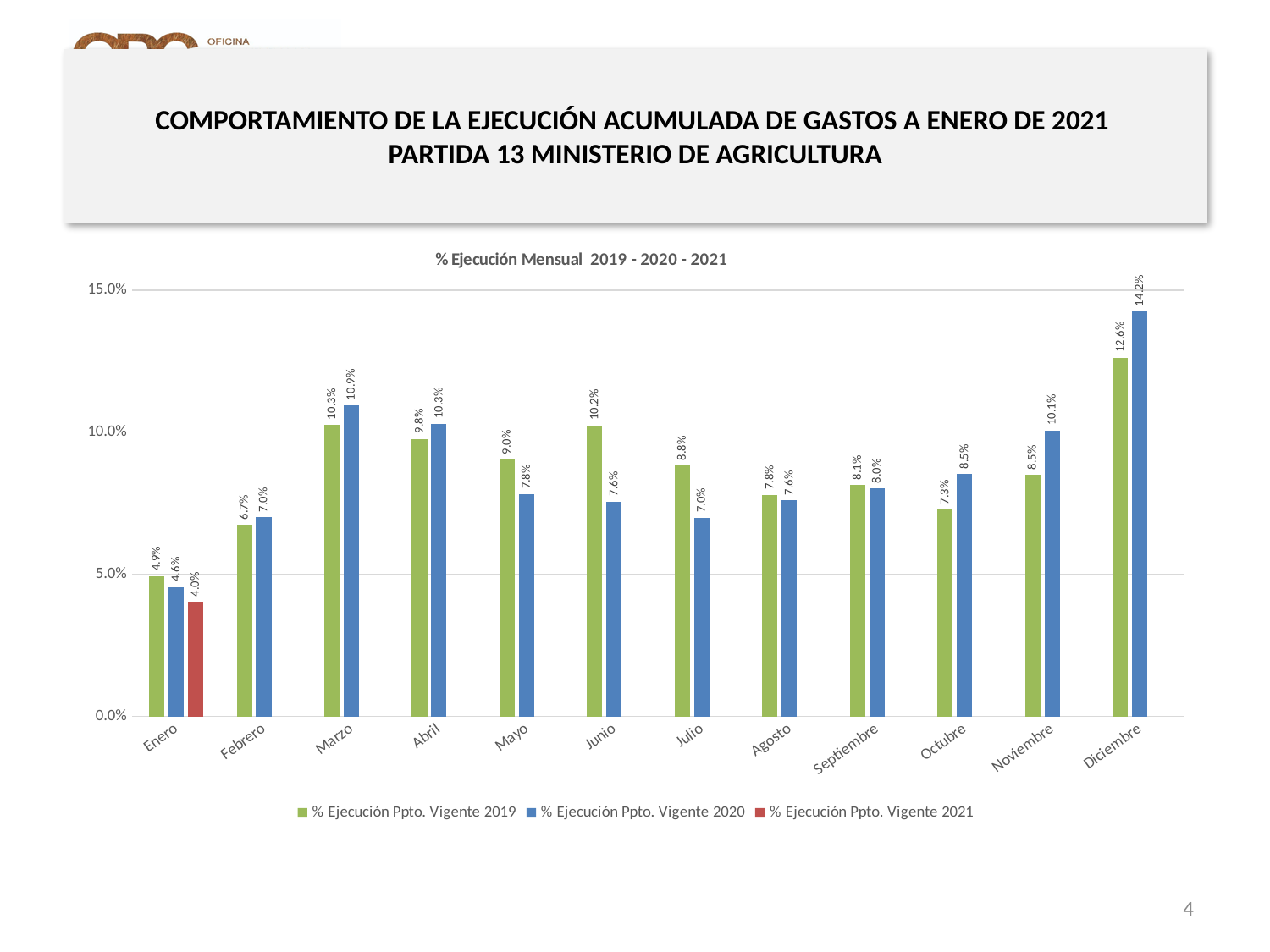
In which month is the % Ejecución Ppto. Vigente 2019 series lowest? Enero Which is larger in Mayo: the 2019 value or the 2020 value? 2019 (9.0%) What is the value for % Ejecución Ppto. Vigente 2019 in Junio? 10.2% How many series does the legend list? 3 What is the value for % Ejecución Ppto. Vigente 2021 in Enero? 4.0% What kind of chart is shown on the slide? Bar chart In which month is the % Ejecución Ppto. Vigente 2020 series highest? Diciembre How many months are shown on the x axis? 12 What is the value for % Ejecución Ppto. Vigente 2020 in Noviembre? 10.1% What is the difference between the 2020 and 2019 values in Diciembre? 1.6% What is the title of the chart? % Ejecución Mensual 2019 - 2020 - 2021 What is the difference between the 2019 and 2020 values in Junio? 2.6%